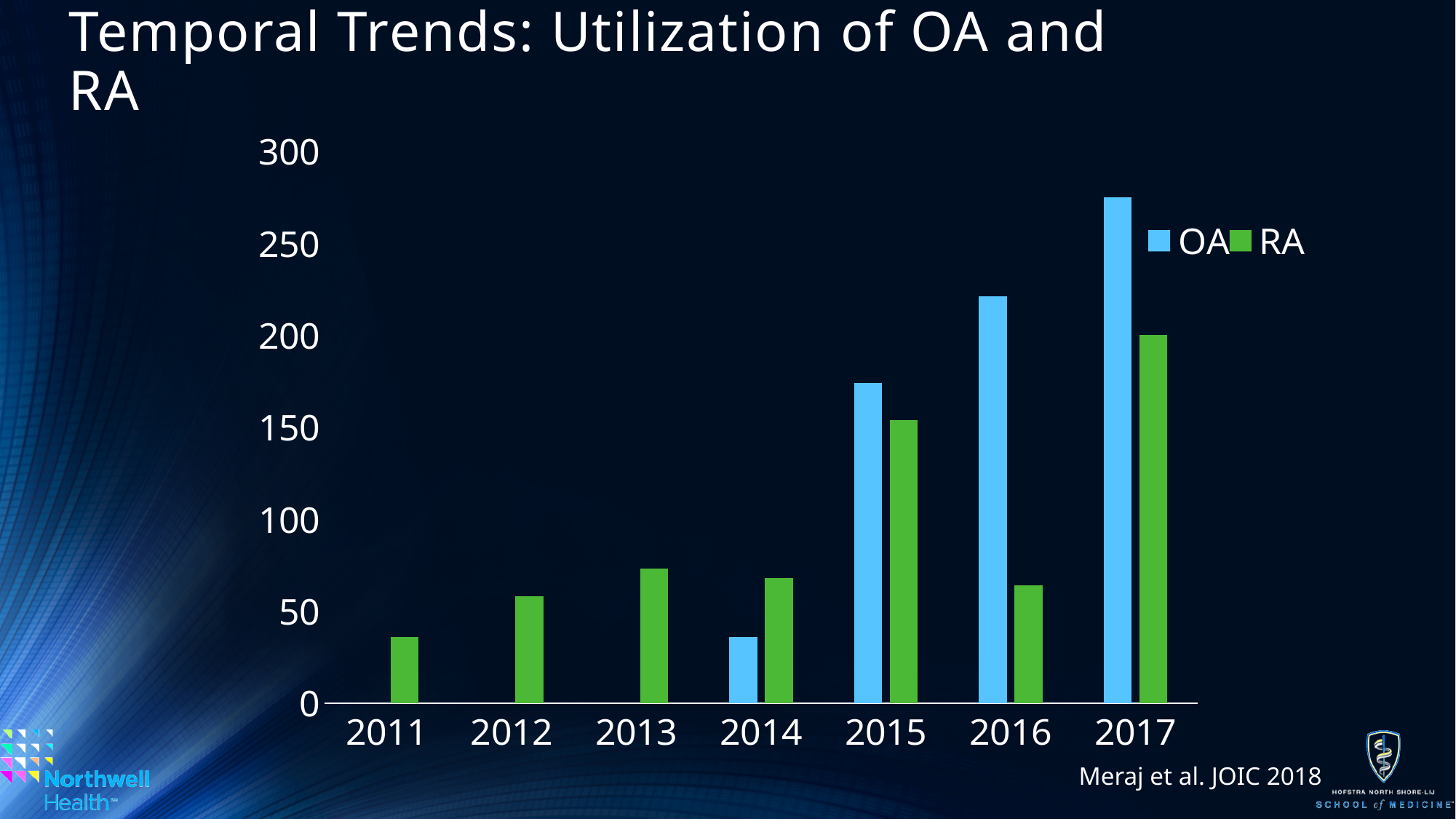
What kind of chart is shown on the slide? bar chart Is the OA value for 2016 greater or less than 200? greater How many years are shown on the x axis? 7 How many series does the legend list? 2 Do the OA values rise or fall from 2014 to 2017? rise What colour are the OA bars? blue Is the OA value for 2017 greater or less than 250? greater In which year is the OA value highest? 2017 In 2016, which is larger, the OA value or the RA value? OA Is the RA value for 2011 greater or less than 50? less In which year is the RA value highest? 2017